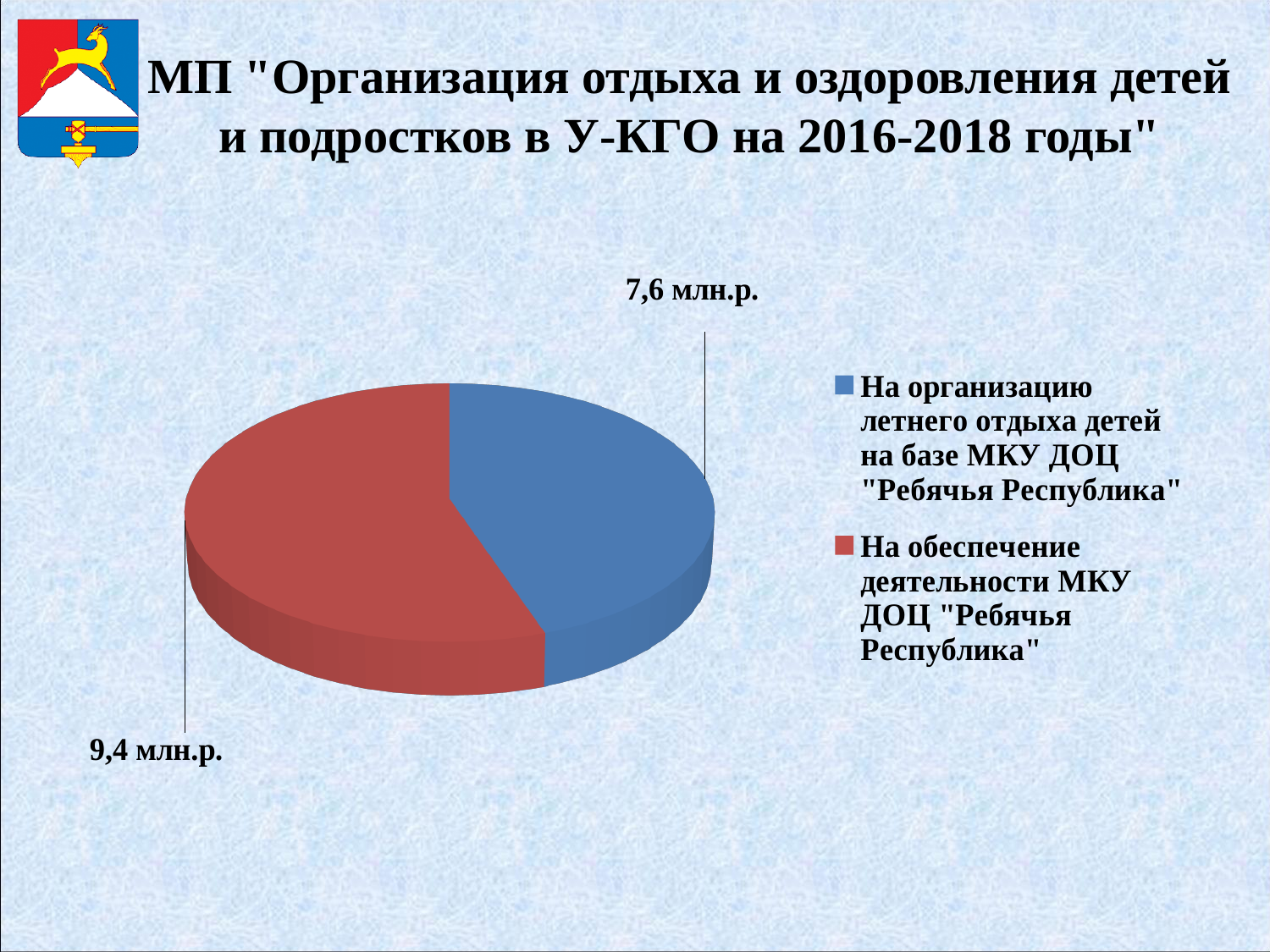
What is the difference between the value for "На обеспечение деятельности МКУ ДОЦ "Ребячья Республика"" and the value for "На организацию летнего отдыха детей на базе МКУ ДОЦ "Ребячья Республика""? 1,8 млн.р. What colour is the slice for "На обеспечение деятельности МКУ ДОЦ "Ребячья Республика""? Red How many slices does the pie chart have? 2 What is the value for "На организацию летнего отдыха детей на базе МКУ ДОЦ "Ребячья Республика""? 7,6 млн.р. Which category has the largest slice of the pie? На обеспечение деятельности МКУ ДОЦ "Ребячья Республика" How many entries does the legend list? 2 What is the value for "На обеспечение деятельности МКУ ДОЦ "Ребячья Республика""? 9,4 млн.р. Which category has the smallest slice of the pie? На организацию летнего отдыха детей на базе МКУ ДОЦ "Ребячья Республика" What is the total of the two values shown on the pie chart? 17,0 млн.р. Which is larger: the value for "На организацию летнего отдыха детей" or the value for "На обеспечение деятельности МКУ ДОЦ"? На обеспечение деятельности МКУ ДОЦ "Ребячья Республика" What kind of chart is shown on the slide? Pie chart What colour is the slice for "На организацию летнего отдыха детей на базе МКУ ДОЦ "Ребячья Республика""? Blue